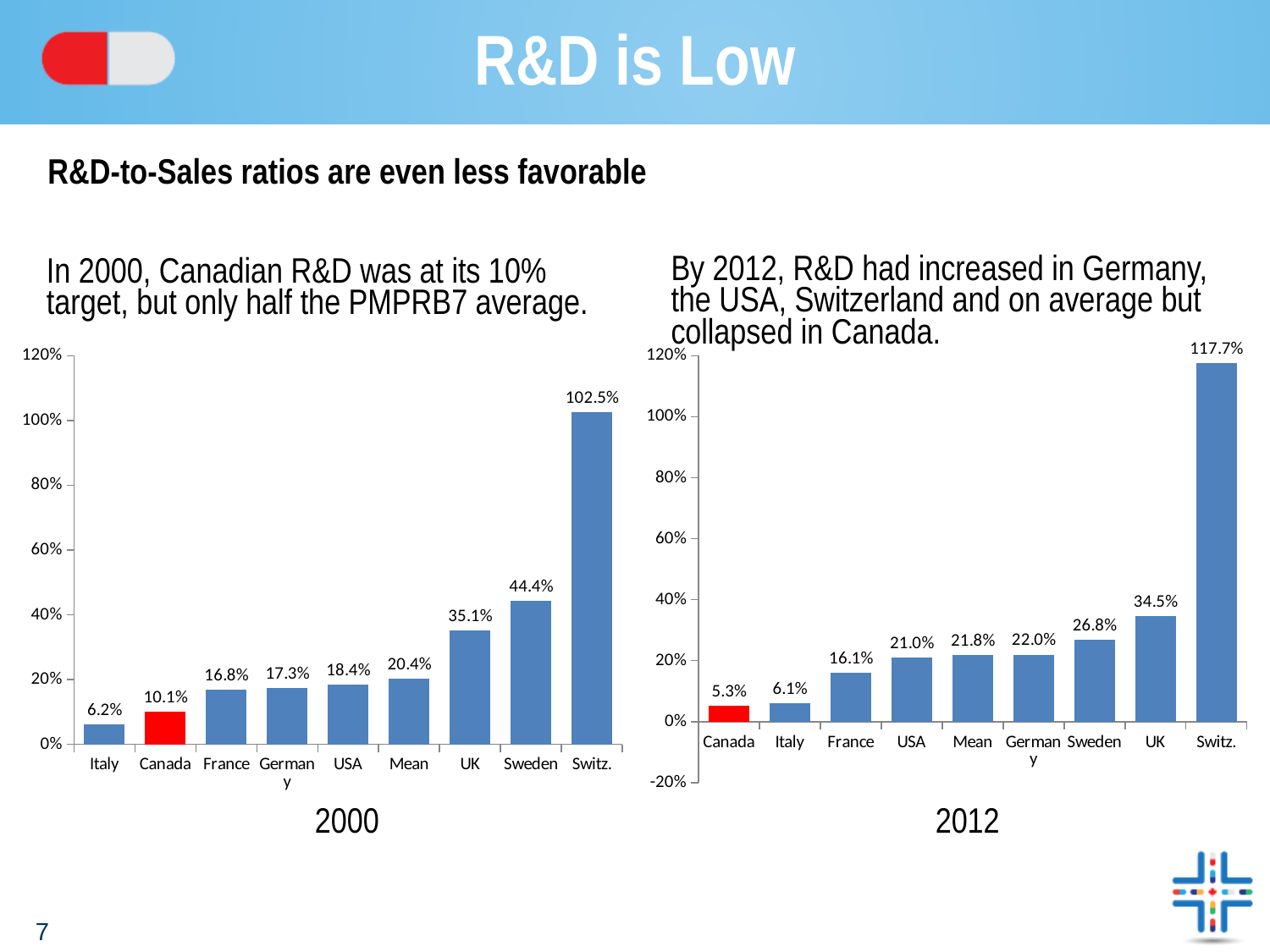
In the 2000 chart, which bar is coloured red? Canada In the 2012 chart, which category has the lowest value? Canada In the 2000 chart, what is the difference between the values for Sweden and the UK? 9.3% In the 2012 chart, what is the value for Canada? 5.3% What kind of chart is the 2000 chart? Bar chart In the 2000 chart, is the value for Switz. greater or less than 100%? greater In the 2012 chart, what is the difference between the values for Switz. and the UK? 83.2% In the 2012 chart, which is larger, the value for the USA or the value for Germany? Germany How many categories are shown in the 2012 chart? 9 In the 2000 chart, what is the value for Canada? 10.1% In the 2012 chart, do the values rise or fall from left to right along the x axis? Rise In the 2000 chart, which country has the highest value? Switz.